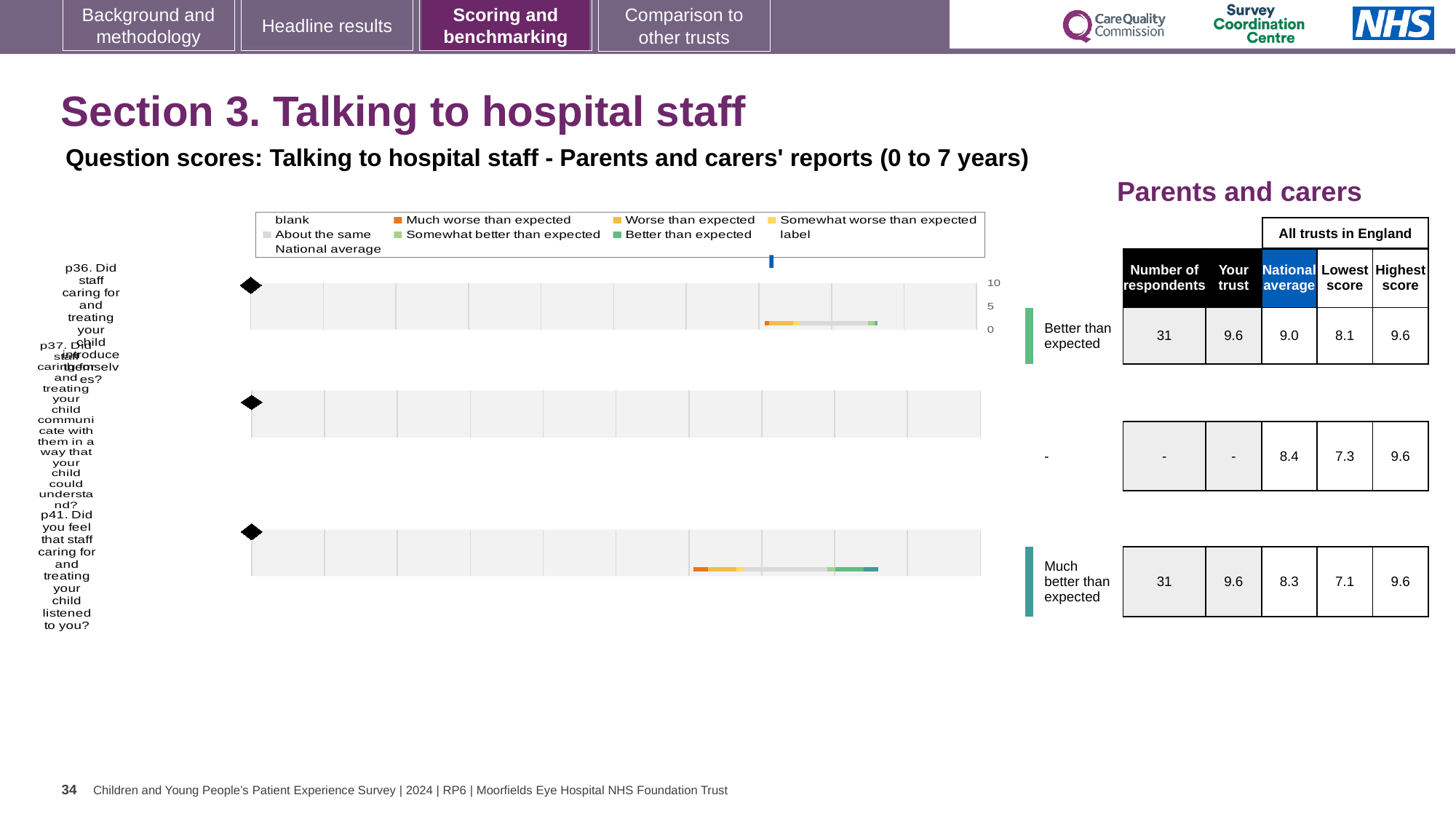
How many survey questions (rows) are plotted in the chart? 3 What benchmark category is shown for p41? Much better than expected What is the highest score among all trusts in England for p37? 9.6 What is the lowest score among all trusts in England for p41? 7.1 What is the difference between the trust's score and the national average for p41? 1.3 How many respondents answered p41? 31 What is the trust's score for p36 (Did staff caring for and treating your child introduce themselves?)? 9.6 Which question has the lower national average, p36 or p41? p41 What is the highest value shown on the chart's score axis? 10 What is the title of the table to the right of the chart? Parents and carers What kind of chart is shown on the slide? bar chart What is the national average score for p36? 9.0